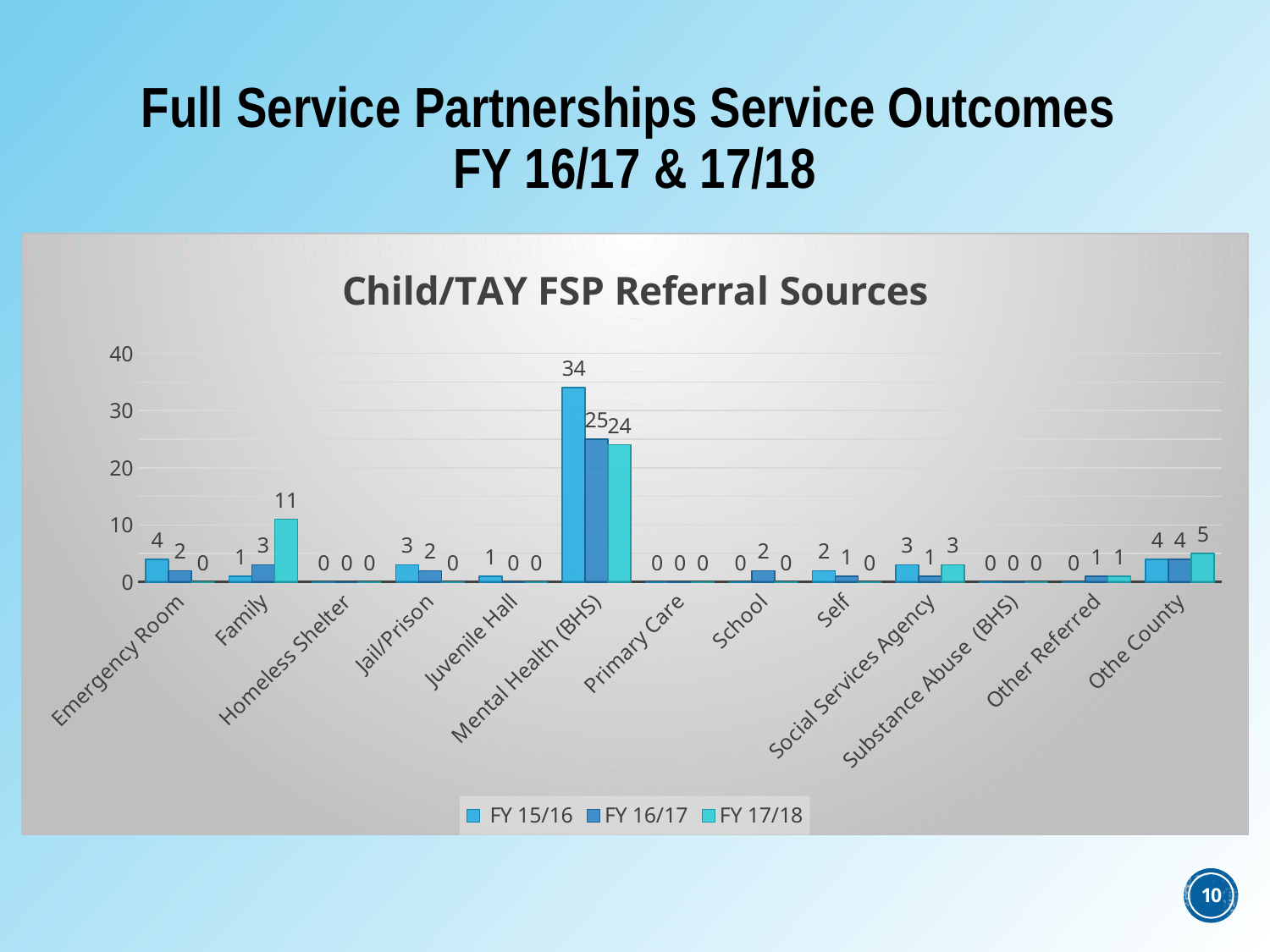
Which referral source has the highest FY 17/18 value? Mental Health (BHS) Is the FY 15/16 value for Mental Health (BHS) greater or less than 30? greater What is the FY 15/16 value for Mental Health (BHS)? 34 What is the FY 16/17 value for Emergency Room? 2 Which is larger for Jail/Prison: the FY 15/16 value or the FY 16/17 value? FY 15/16 What kind of chart is shown on the slide? Bar chart What is the FY 17/18 value for Family? 11 How many series does the legend list? 3 What is the title of the chart? Child/TAY FSP Referral Sources What is the difference between the FY 15/16 and FY 16/17 values for Mental Health (BHS)? 9 How many referral source categories are shown on the x axis? 13 Do the values for Family rise or fall from FY 15/16 to FY 17/18? Rise